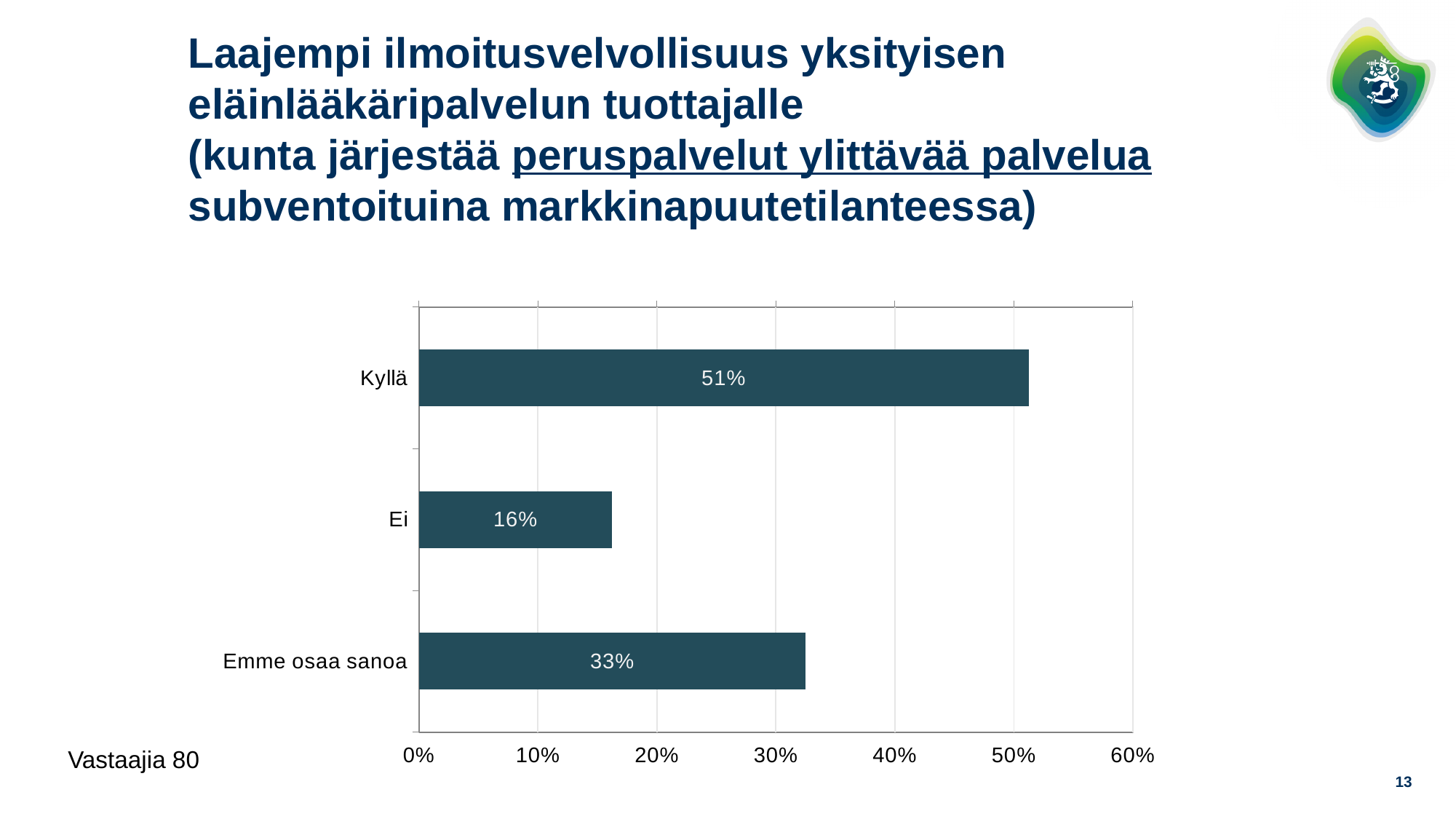
Which category has the lowest value? Ei What is the difference between the values for Emme osaa sanoa and Ei? 17% What is the value for Emme osaa sanoa? 33% What is the highest value shown on the x axis of the chart? 60% Is the value for Kyllä greater or less than 40%? greater What is the difference between the values for Kyllä and Ei? 35% What kind of chart is shown on the slide? bar chart Which is larger, the value for Emme osaa sanoa or the value for Ei? Emme osaa sanoa Which category has the highest value? Kyllä What is the value for Kyllä? 51% How many categories are shown in the chart? 3 What is the value for Ei? 16%